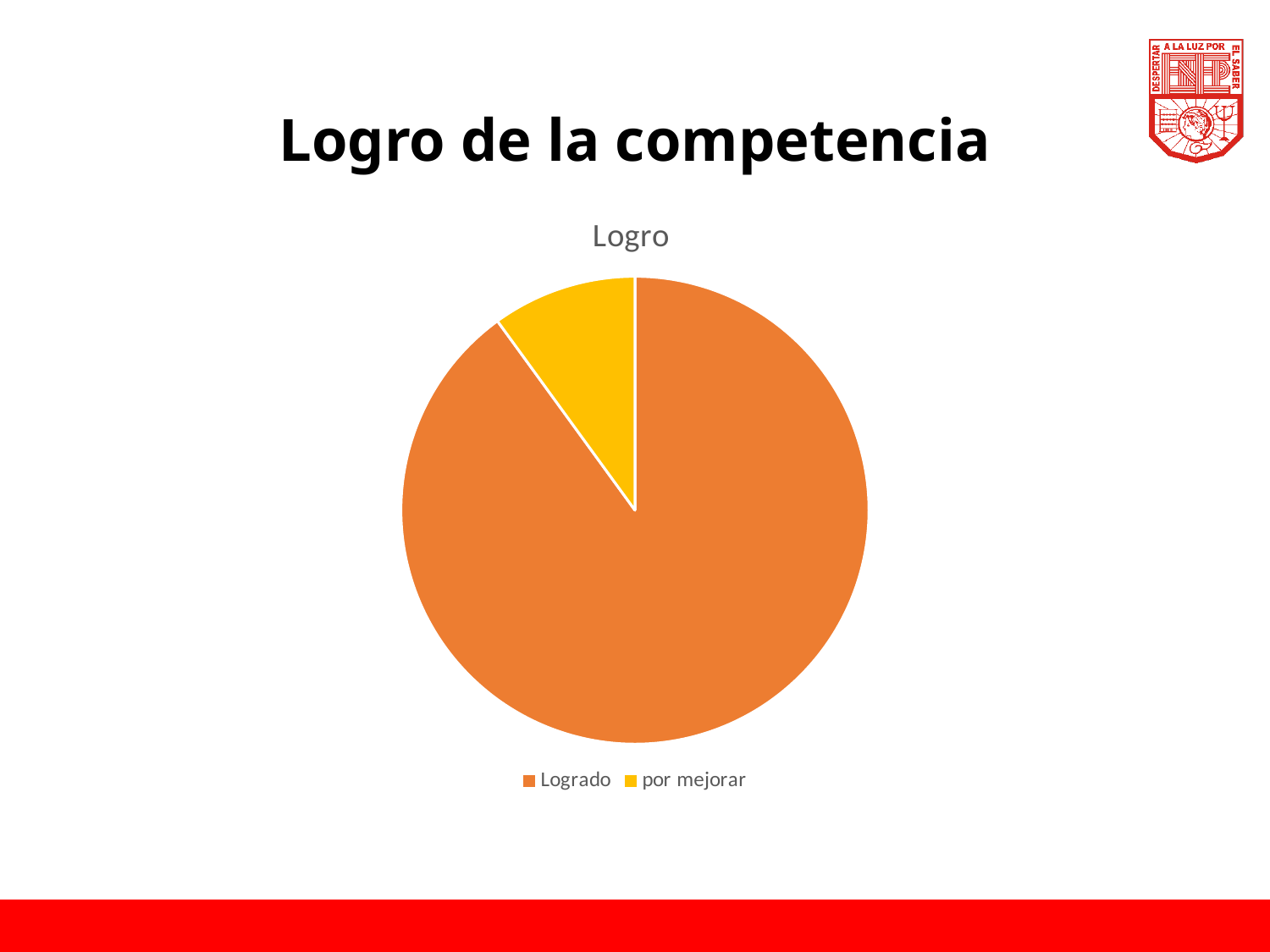
How many slices does the pie chart have? 2 How many entries does the legend list? 2 What kind of chart is shown on the slide? pie chart Which slice is the largest in the pie chart? Logrado Does the Logrado slice take up more or less than half of the pie? more What is the title of the chart? Logro Which is larger, the Logrado slice or the por mejorar slice? Logrado Which slice is the smallest in the pie chart? por mejorar What colour is the Logrado slice? orange